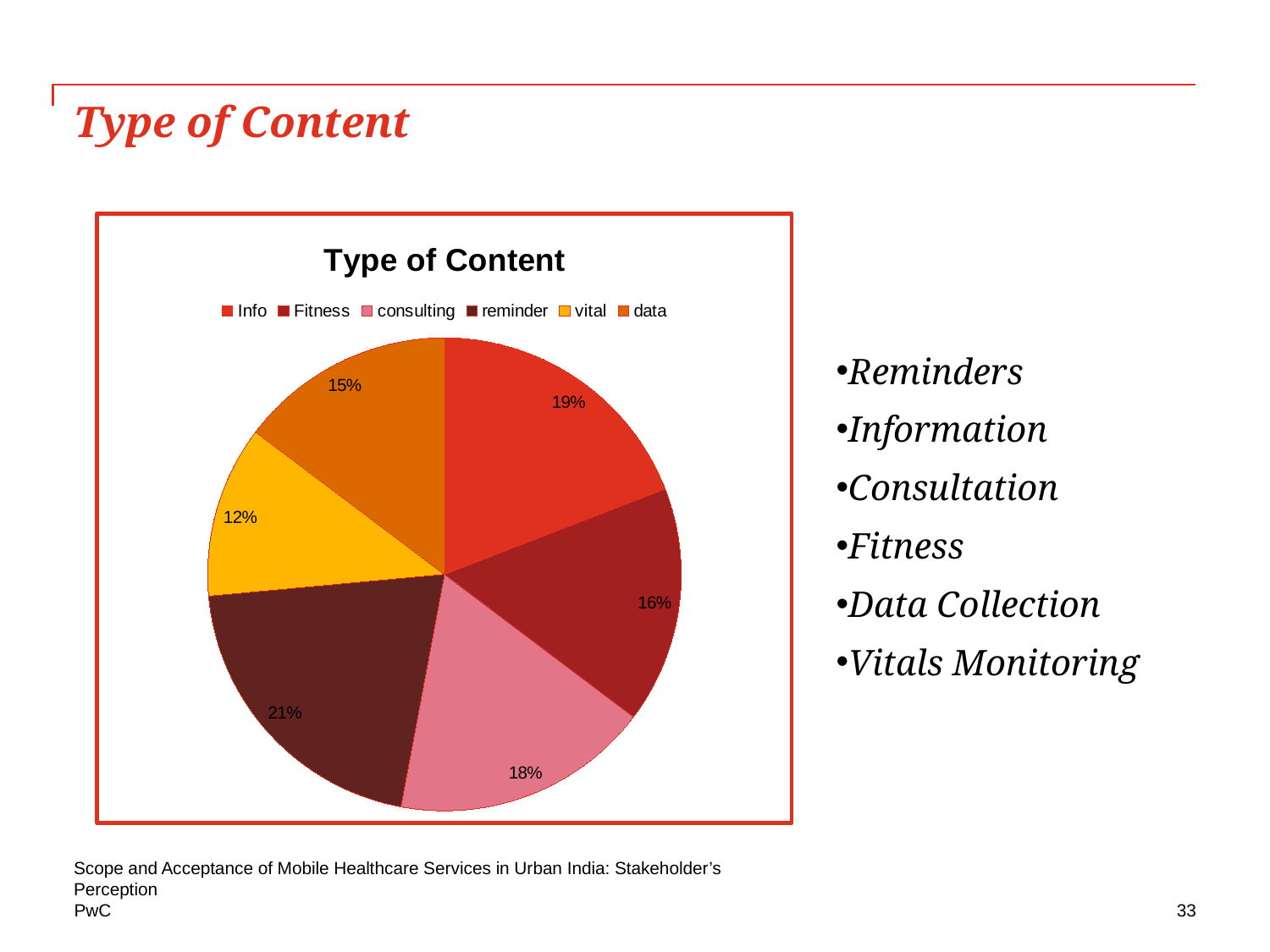
What share of the pie does the vital slice represent? 12% What is the difference between the reminder share and the vital share? 9% What share of the pie does the reminder slice represent? 21% What is the value shown for the consulting slice? 18% Which category has the largest share of the pie? reminder What is the value shown for the data slice? 15% What share of the pie does the Info slice represent? 19% How many categories does the legend of the pie chart list? 6 What type of chart is shown on the slide? Pie chart Which category has the smallest share of the pie? vital What is the title of the chart? Type of Content Which is larger, the Fitness share or the consulting share? consulting